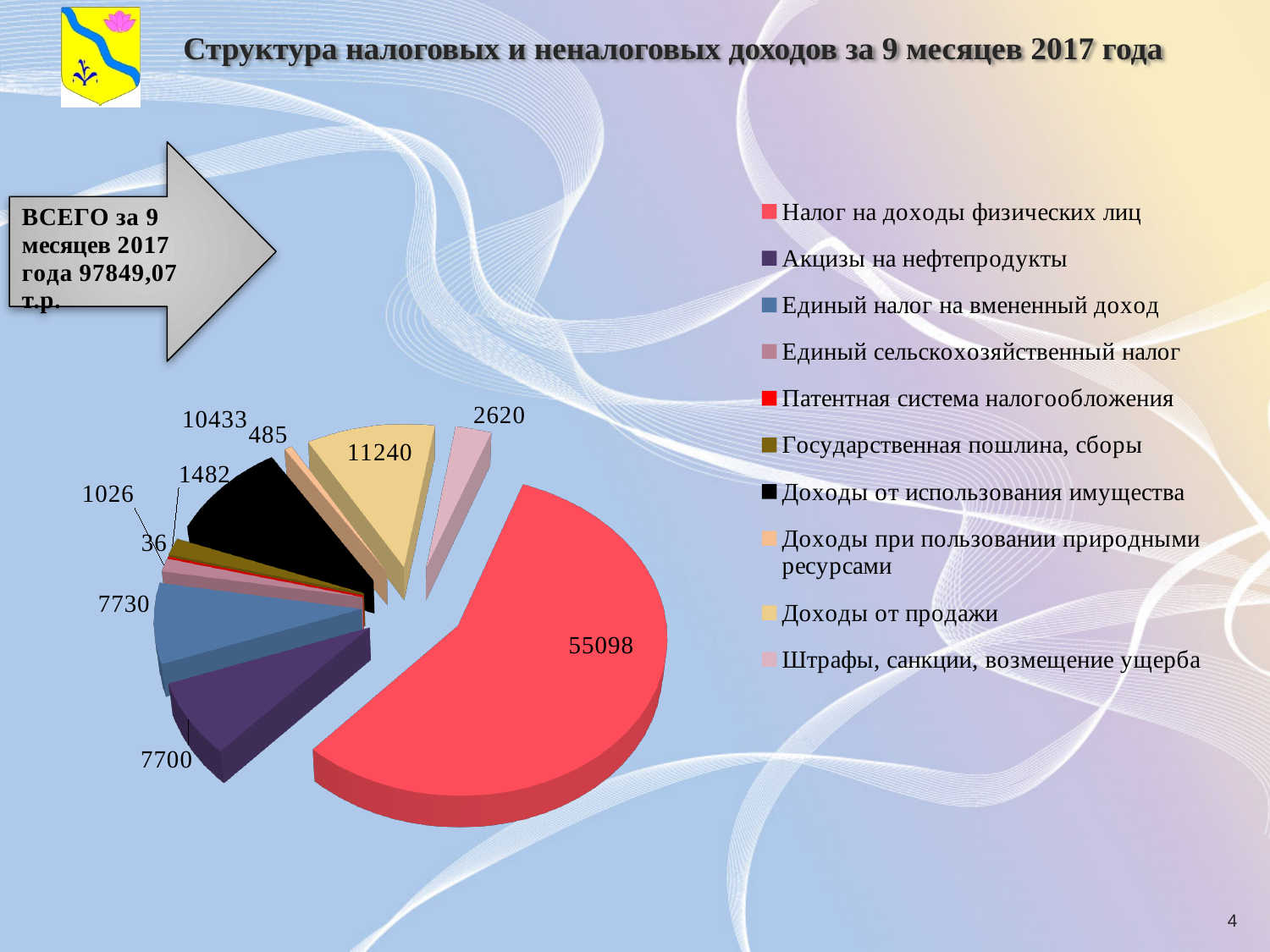
What is the value for Штрафы, санкции, возмещение ущерба? 2620 What is the value for Налог на доходы физических лиц? 55098 What type of chart is shown on the slide? pie chart What is the difference between the values for Доходы от продажи and Доходы от использования имущества? 807 What is the value for Доходы от продажи? 11240 What is the value for Патентная система налогообложения? 36 Which is larger: the value for Единый налог на вмененный доход or the value for Акцизы на нефтепродукты? Единый налог на вмененный доход Which category has the largest slice of the pie? Налог на доходы физических лиц What is the title of the slide? Структура налоговых и неналоговых доходов за 9 месяцев 2017 года What is the value for Доходы от использования имущества? 10433 Which category has the smallest slice of the pie? Патентная система налогообложения How many categories does the legend list? 10